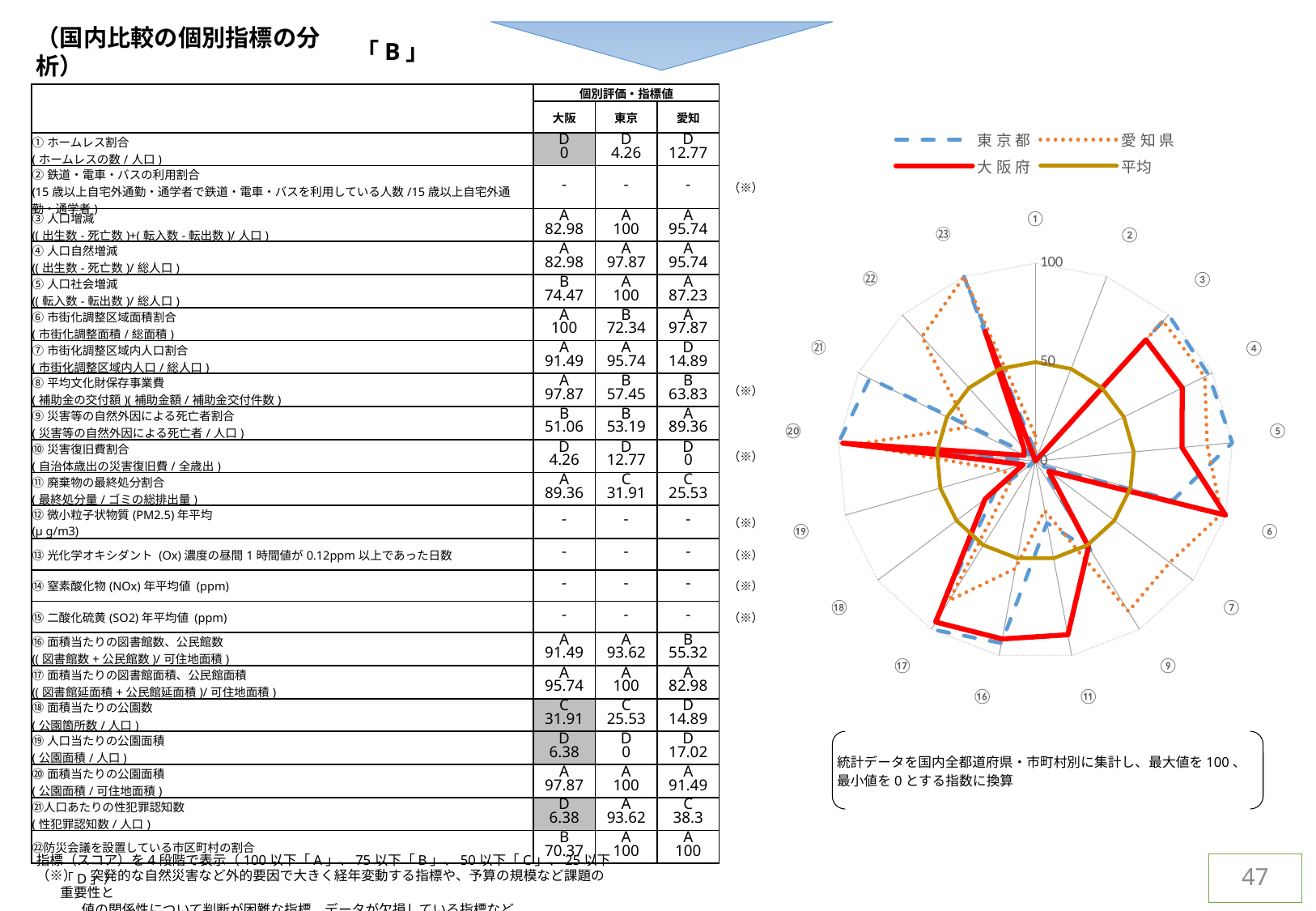
In the radar chart, which series has the larger value at axis ⑥, 大阪府 or 東京都? 大阪府 What colour is the 大阪府 line in the radar chart? red What is the highest value shown on the radial axis of the radar chart? 100 In the radar chart, which series has the larger value at axis ⑪, 大阪府 or 東京都? 大阪府 Which series are listed in the legend of the radar chart? 東京都, 愛知県, 大阪府, 平均 How many series does the legend of the radar chart list? 4 What kind of chart is shown on the right side of the slide? radar chart In the radar chart, is the value for 東京都 at axis ⑪ greater or less than 50? less In the radar chart, is the value for 大阪府 at axis ⑳ greater or less than 50? greater In the radar chart, is the value for 愛知県 at axis ⑦ greater or less than 50? greater In the radar chart, which series has the larger value at axis ⑦, 大阪府 or 愛知県? 愛知県